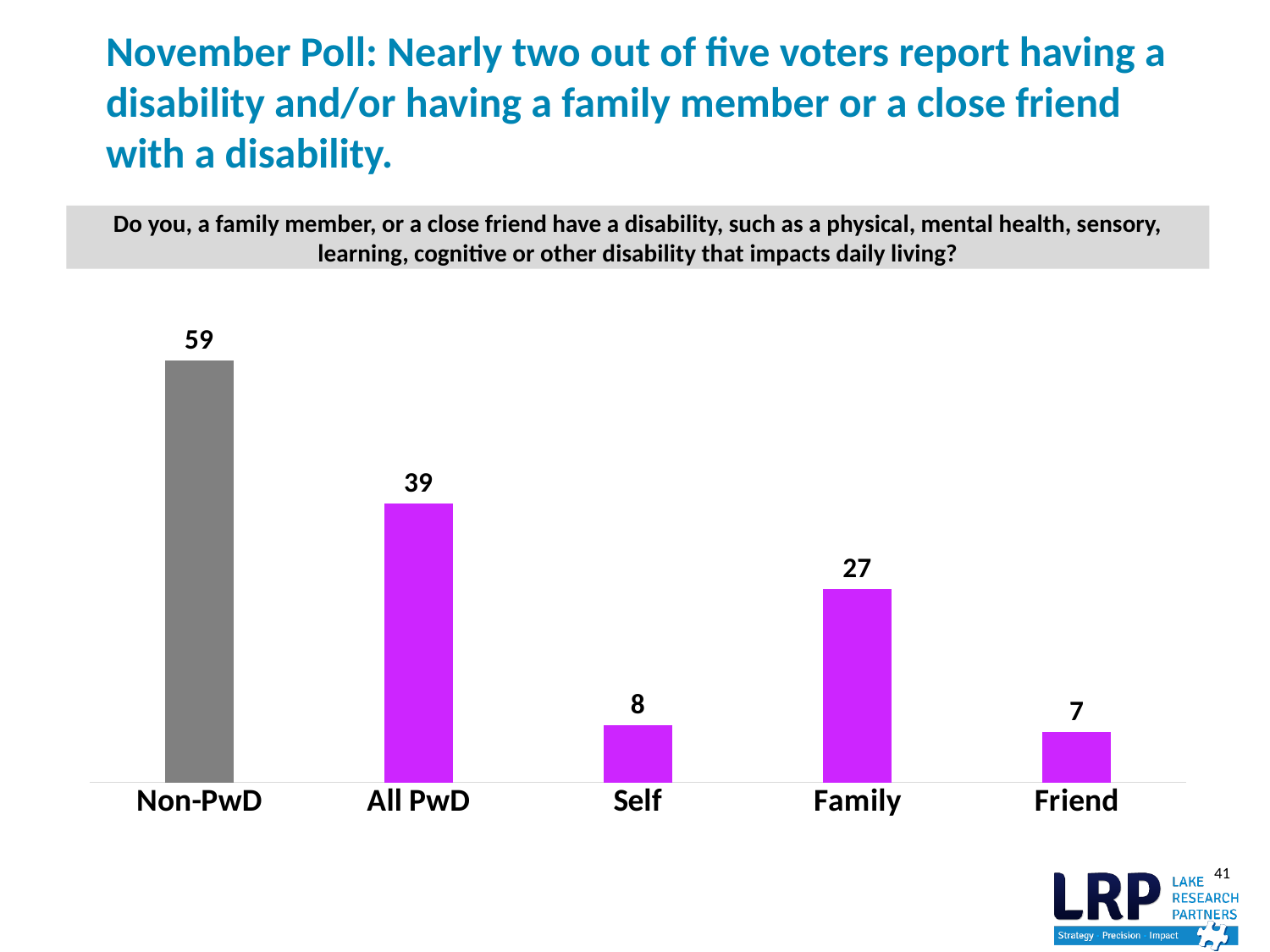
Which category has the highest value? Non-PwD What is the difference between the values for Non-PwD and All PwD? 20 Which category has the lowest value? Friend What is the difference between the values for Family and Self? 19 What is the value for Friend? 7 What is the value for Self? 8 What is the value for Family? 27 What is the value for Non-PwD? 59 How many categories are shown on the x axis? 5 Which is larger, the value for Family or the value for Self? Family What kind of chart is shown on the slide? Bar chart What is the value for All PwD? 39